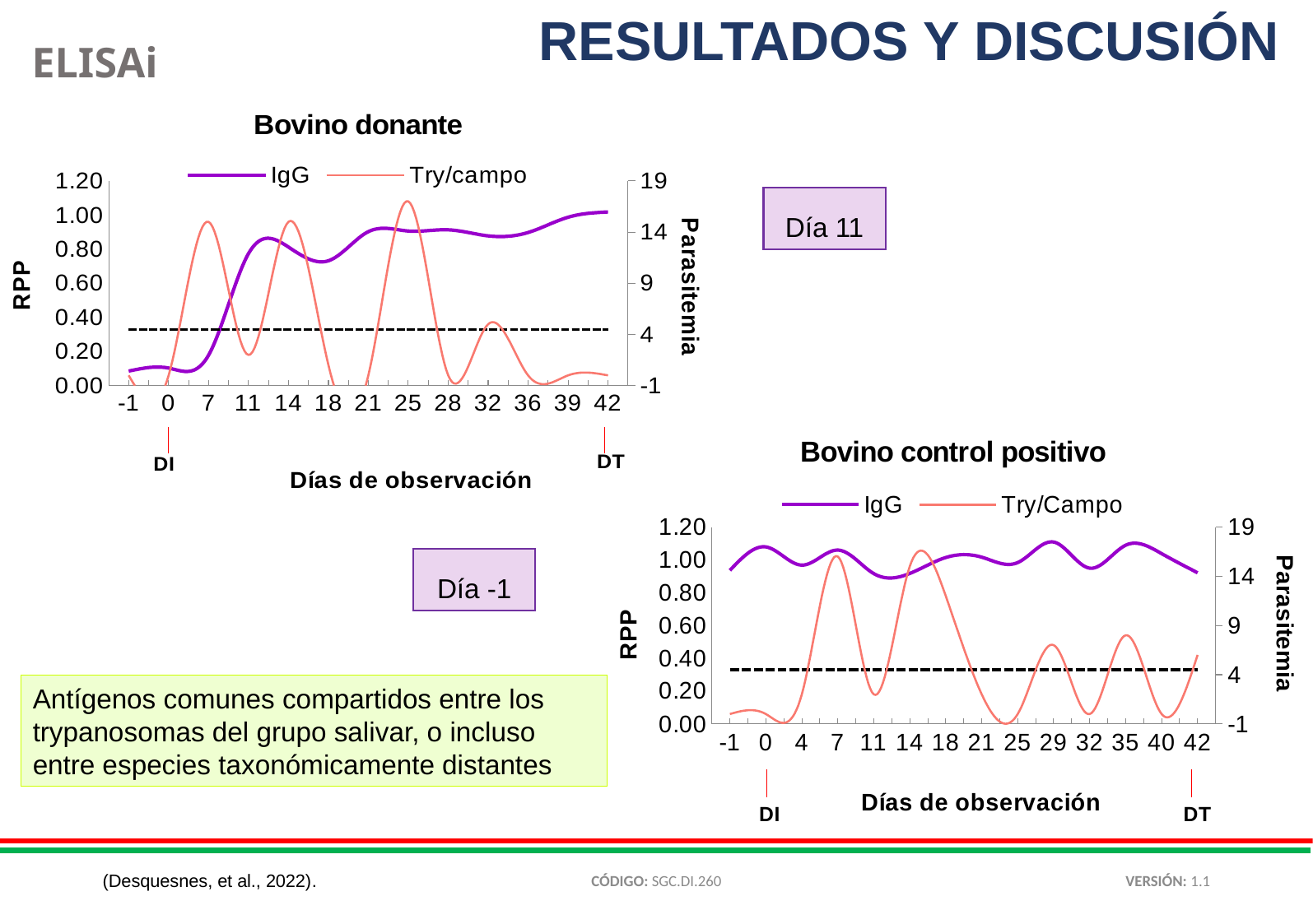
What are the two series named in the legend of the "Bovino donante" chart? IgG and Try/campo In the "Bovino donante" chart, is the IgG value at day 42 greater or less than 0.80? greater In the "Bovino donante" chart, is the Try/campo value at day 7 greater or less than 9? greater In the "Bovino control positivo" chart, is the Try/Campo value at day 25 greater or less than 4? less How many days of observation are marked on the x axis of the "Bovino control positivo" chart? 14 What is the title of the right-hand vertical axis of the "Bovino control positivo" chart? Parasitemia What kind of chart is the "Bovino donante" chart? line chart How many days of observation are marked on the x axis of the "Bovino donante" chart? 13 How many series does the legend of the "Bovino control positivo" chart list? 2 In the "Bovino donante" chart, does the IgG series overall rise or fall from day -1 to day 42? rise